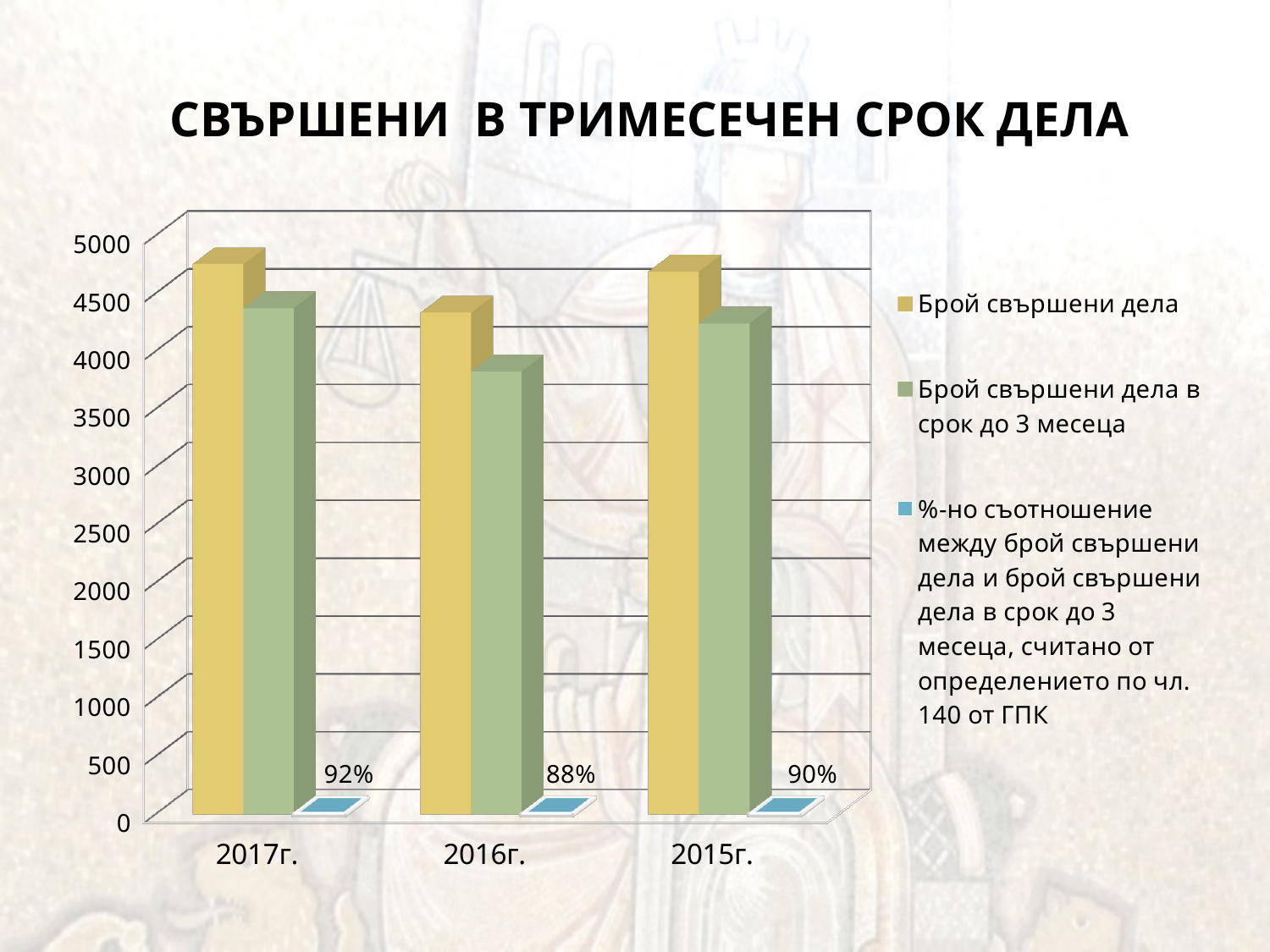
What is the difference between the percentage labels for 2017г. and 2016г.? 4% Which year has the lowest percentage label? 2016г. How many years are shown on the x axis? 3 Which year has the highest percentage label? 2017г. What is the percentage value shown for 2017г.? 92% What kind of chart is shown on the slide? bar chart How many series does the legend list? 3 What is the percentage value shown for 2016г.? 88% What is the percentage value shown for 2015г.? 90% Is the value of 'Брой свършени дела в срок до 3 месеца' for 2016г. greater or less than 4500? less Which year has the larger percentage label, 2017г. or 2015г.? 2017г. Is the value of 'Брой свършени дела' for 2017г. greater or less than 4500? greater